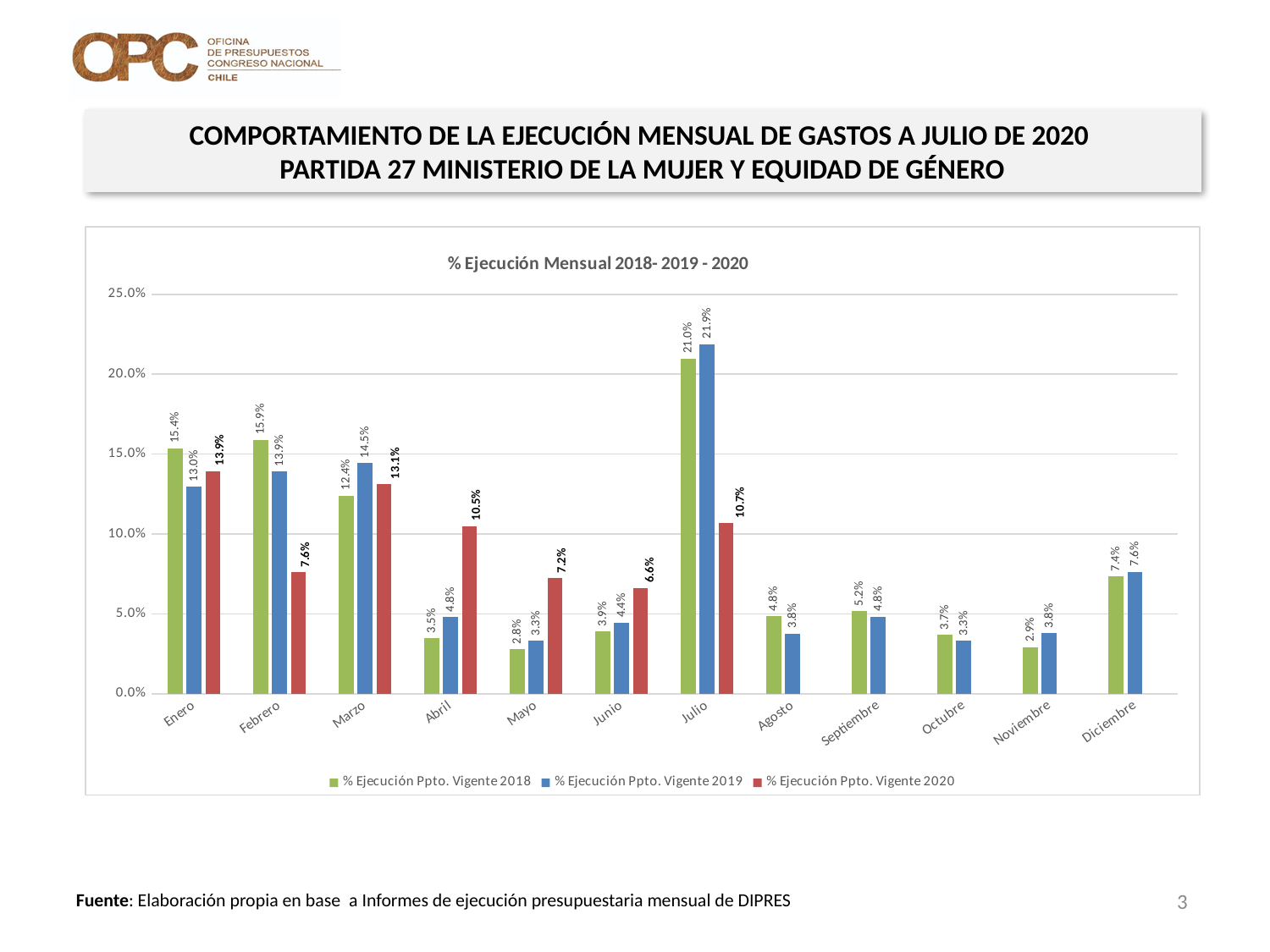
In which month is the % Ejecución Ppto. Vigente 2018 series lowest? Mayo What is the difference between the 2019 and 2018 values in Julio? 0.9% What is the value for % Ejecución Ppto. Vigente 2020 in Abril? 10.5% Is the value for % Ejecución Ppto. Vigente 2020 in Julio greater or less than 10.0%? greater What kind of chart is shown on the slide? Bar chart What is the value for % Ejecución Ppto. Vigente 2019 in Julio? 21.9% In which month is the % Ejecución Ppto. Vigente 2020 series highest? Enero What is the value for % Ejecución Ppto. Vigente 2018 in Diciembre? 7.4% How many months are shown on the x axis? 12 How many series does the legend list? 3 What is the title of the chart? % Ejecución Mensual 2018- 2019 - 2020 Which is larger in Febrero: the 2018 value or the 2020 value? 2018